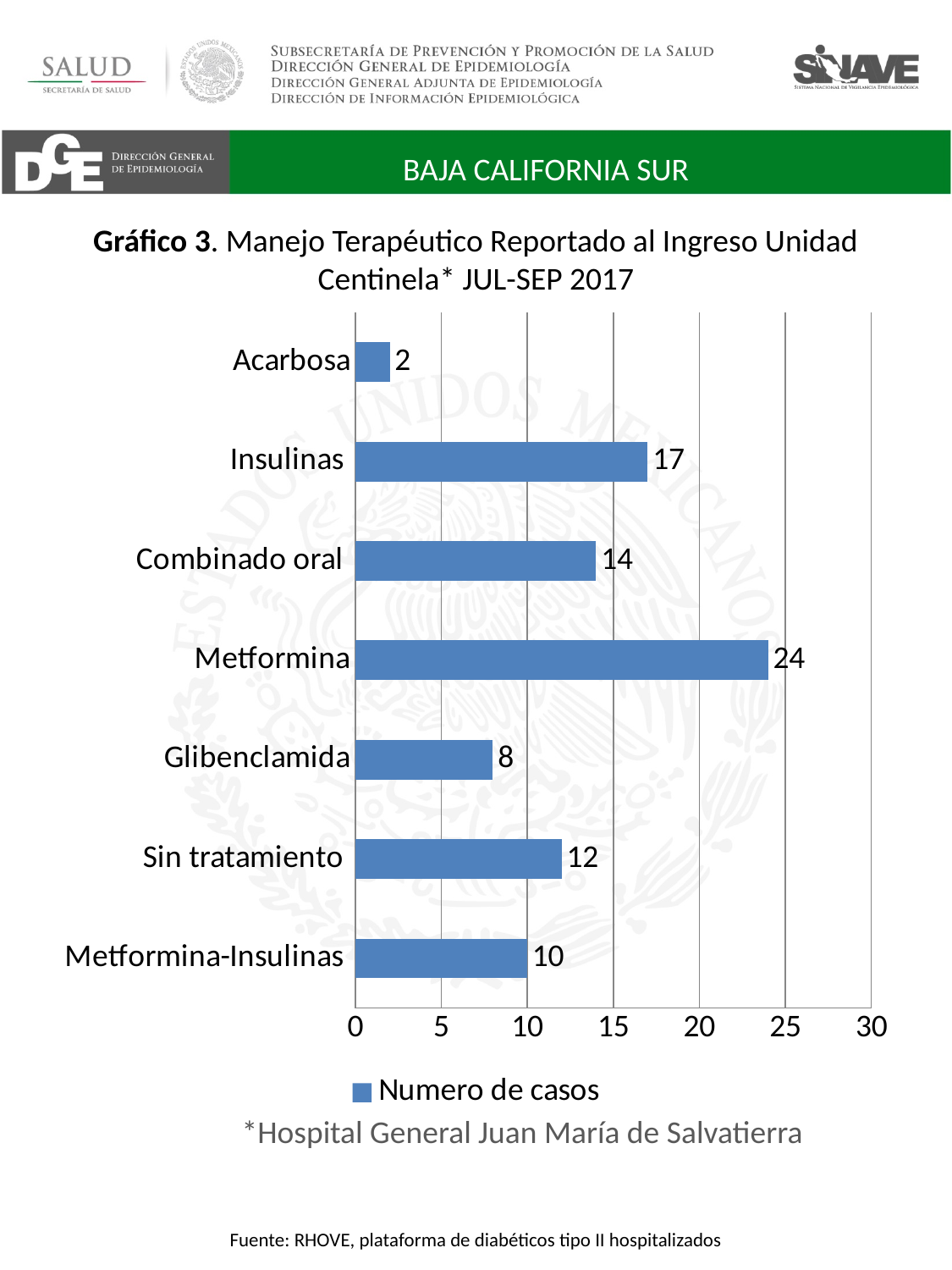
What kind of chart is shown on the slide? Bar chart What is the difference in number of cases between Metformina and Glibenclamida? 16 Which category has the highest number of cases? Metformina What is the number of cases for Metformina? 24 What is the legend entry for the series in the chart? Numero de casos What is the number of cases for Sin tratamiento? 12 Which has more cases, Combinado oral or Metformina-Insulinas? Combinado oral What is the number of cases for Insulinas? 17 How many categories are shown in the chart? 7 How many series does the legend list? 1 What is the difference in number of cases between Insulinas and Acarbosa? 15 Which category has the lowest number of cases? Acarbosa